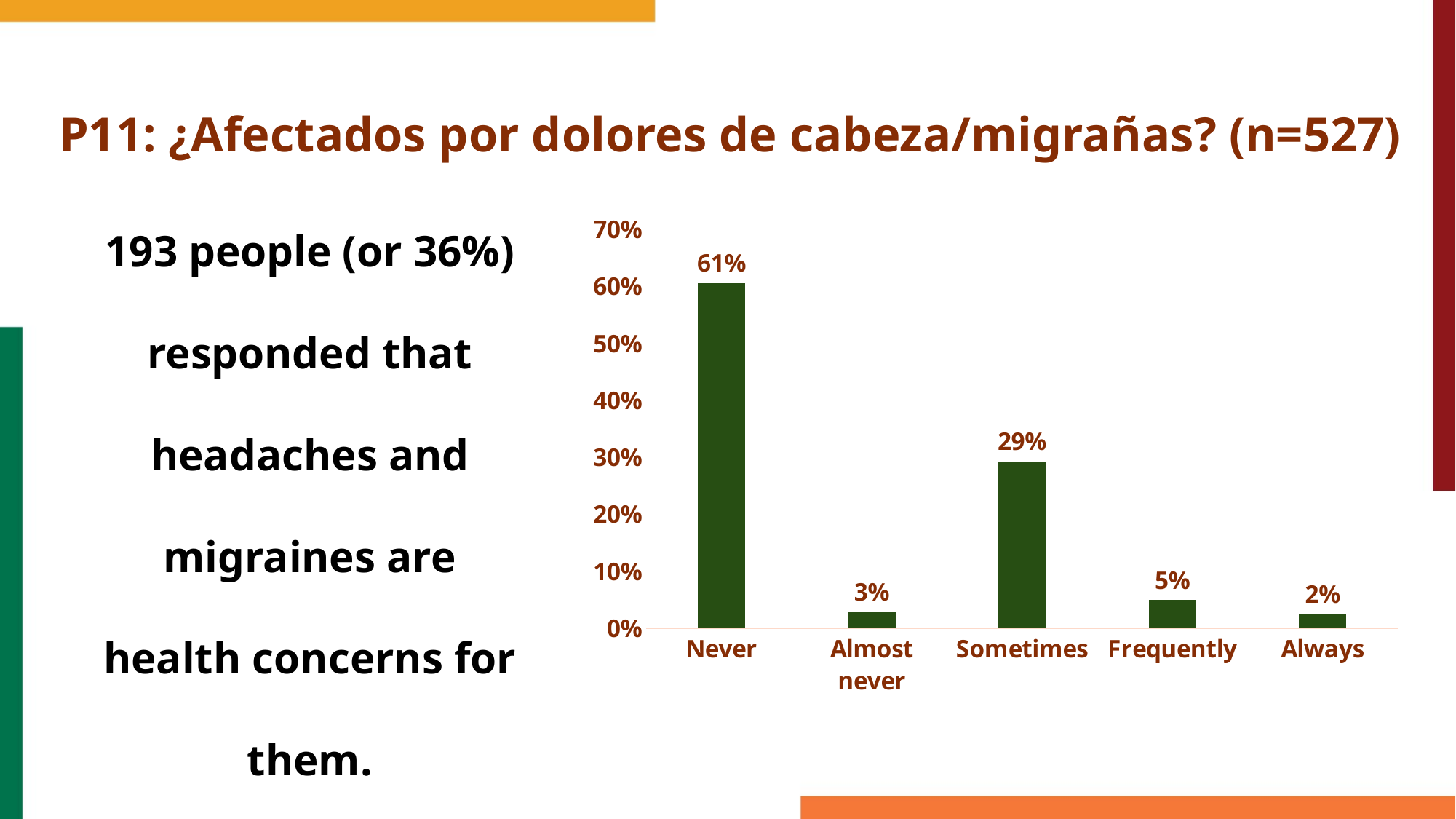
What percentage of respondents answered "Almost never"? 3% Which category has the lowest value? Always Which is larger, the value for "Frequently" or the value for "Almost never"? Frequently How many categories are shown on the x axis? 5 What kind of chart is shown on the slide? bar chart What is the sample size (n) given in the slide title? 527 Is the value for "Sometimes" greater or less than 30%? less What percentage of respondents answered "Never"? 61% Which category has the highest value? Never What percentage of respondents answered "Always"? 2% What is the difference between the "Never" and "Sometimes" values? 32% What percentage of respondents answered "Sometimes"? 29%